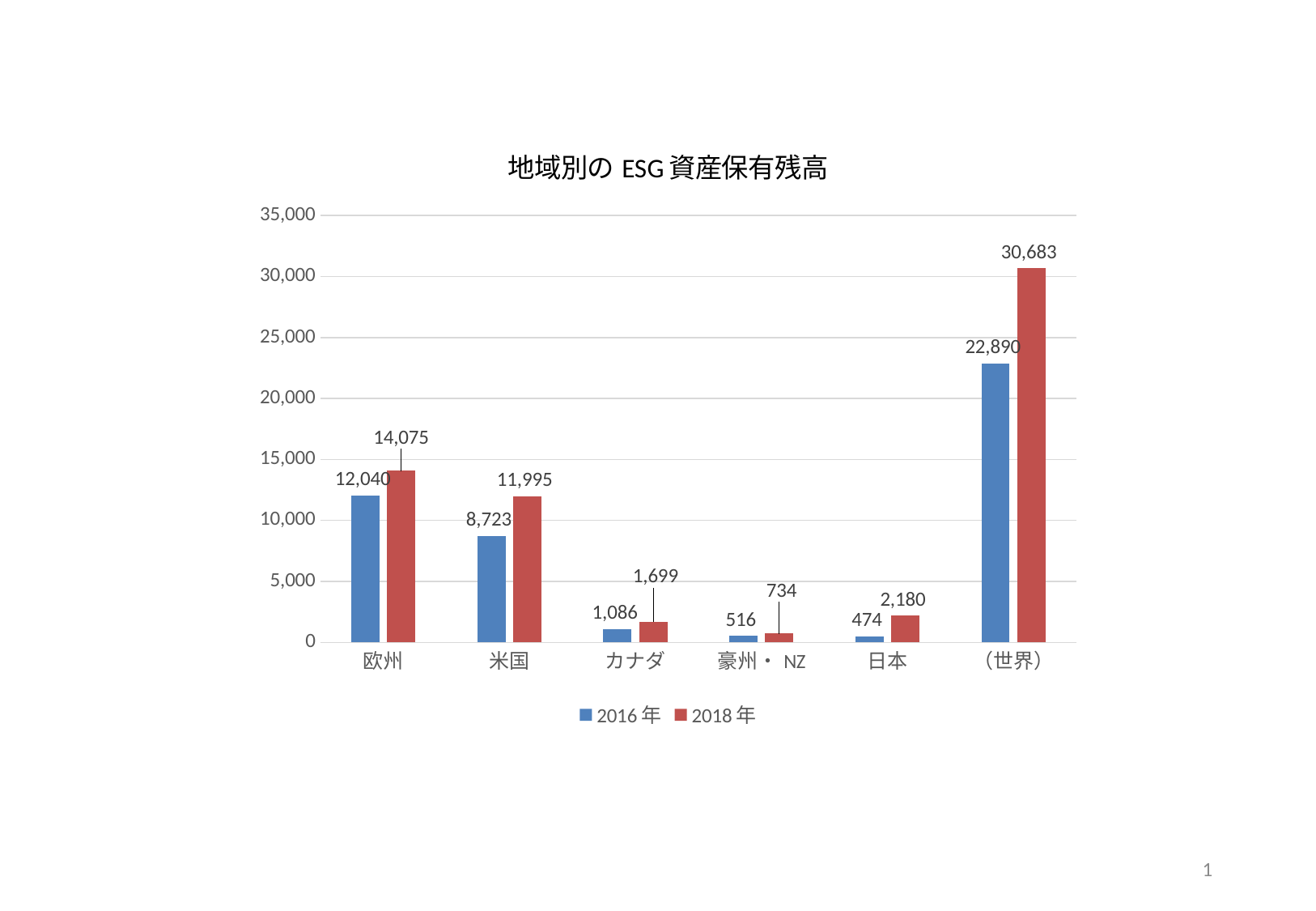
What is the difference between the 2018年 and 2016年 values for （世界）? 7,793 Which category has the highest 2018年 value? （世界） What is the difference between the 2018年 and 2016年 values for カナダ? 613 What is the 2018年 value for 日本? 2,180 What is the 2018年 value for 欧州? 14,075 Which is larger: the 2016年 value for 欧州 or the 2018年 value for 米国? 2016年 value for 欧州 Which category has the lowest 2016年 value? 日本 How many series does the legend list? 2 How many categories are shown on the x axis? 6 What is the 2016年 value for 豪州・NZ? 516 What is the 2016年 value for 米国? 8,723 What kind of chart is shown on the slide? Bar chart